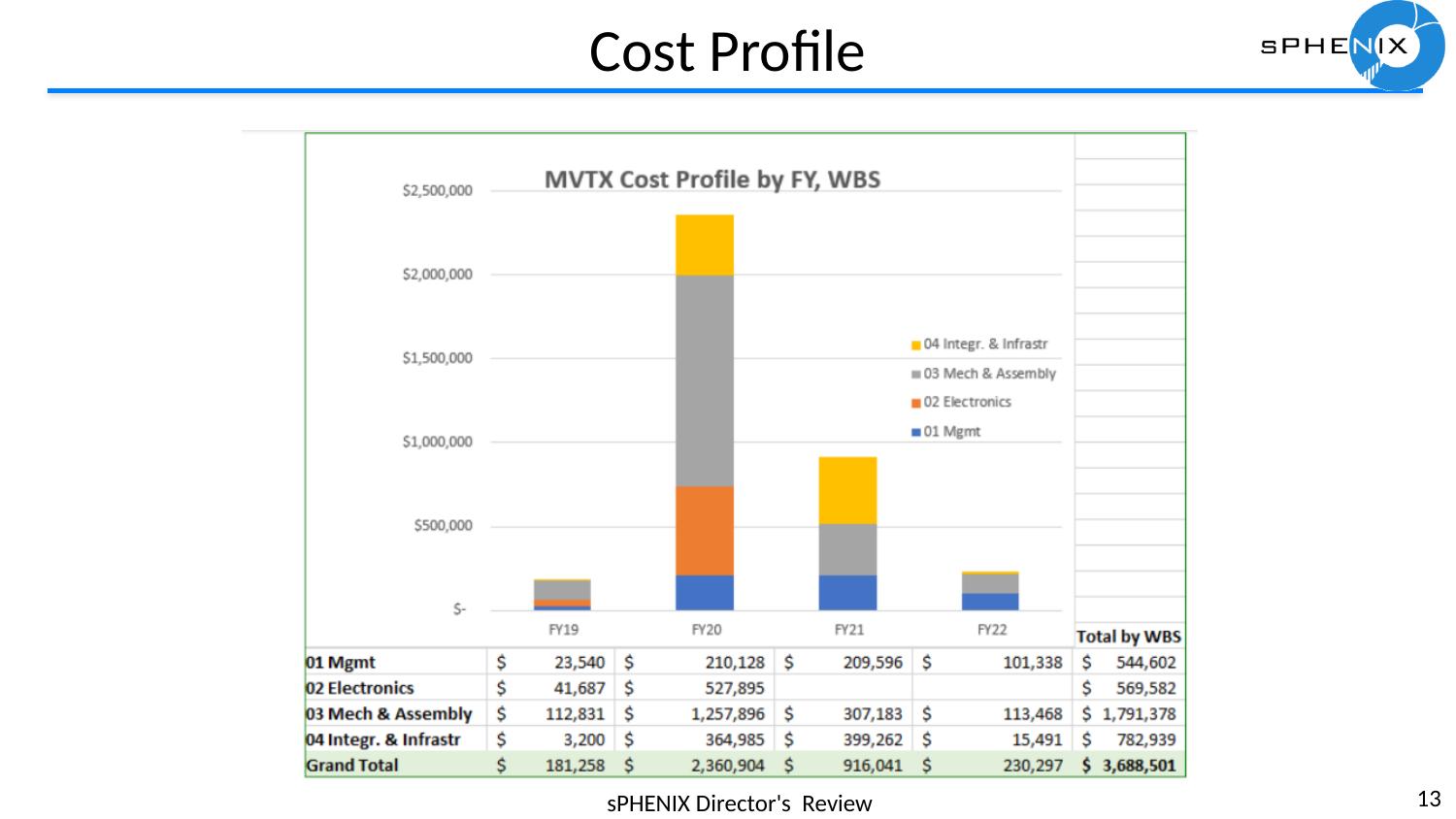
How many fiscal years are shown on the x axis? 4 Which is larger, the 01 Mgmt value for FY20 or for FY21? FY20 Which fiscal year has the lowest total cost? FY19 What is the value for 01 Mgmt in FY19? $23,540 What is the title of the chart? MVTX Cost Profile by FY, WBS What is the value for 03 Mech & Assembly in FY20? $1,257,896 Which fiscal year has the highest total cost? FY20 What is the Grand Total for FY21? $916,041 How many series does the legend list? 4 Is the total stacked bar for FY22 greater or less than $500,000? less What type of chart is shown on the slide? Stacked bar chart What is the difference between the 04 Integr. & Infrastr values for FY21 and FY20? $34,277